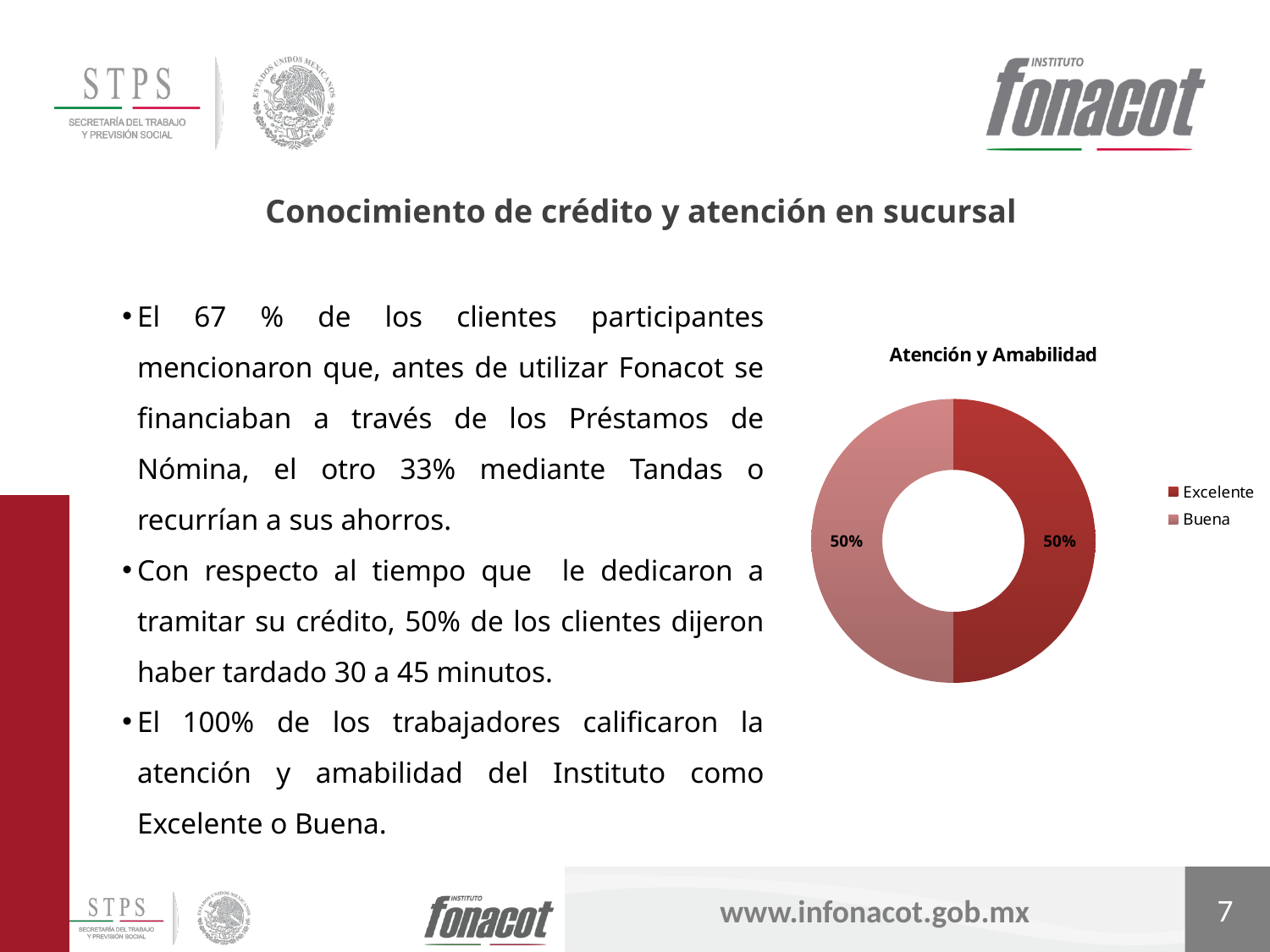
Which legend entry is shown in the darker red colour in the chart? Excelente What is the title of the chart on the slide? Atención y Amabilidad How many entries does the legend of the chart list? 2 What do the Excelente and Buena slices add up to in the chart? 100% What kind of chart is shown on the slide? doughnut chart What is the difference between the Excelente and Buena values in the chart? 0% How many slices does the Atención y Amabilidad chart have? 2 What is the value for Buena in the Atención y Amabilidad chart? 50% What share of the chart does the Buena slice represent? 50% What is the value for Excelente in the Atención y Amabilidad chart? 50%